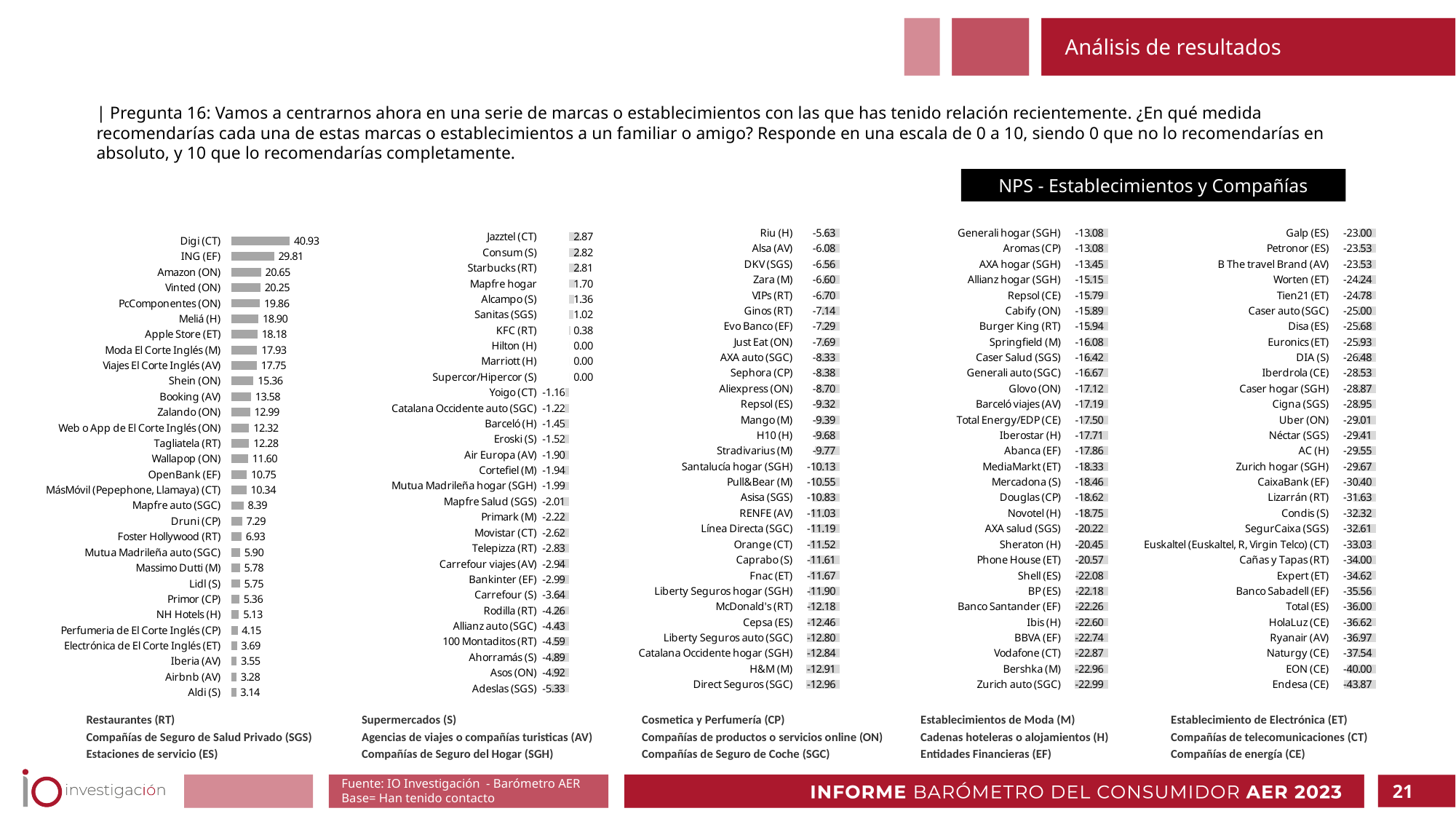
What kind of chart is used to show the NPS values? Bar chart Which brand or establishment has the highest NPS on the chart? Digi (CT) What is the NPS value shown for Digi (CT)? 40.93 How many brands on the chart have an NPS of exactly 0.00? 3 What is the difference between the NPS of Amazon (ON) and Vinted (ON)? 0.40 What is the difference between the NPS of Digi (CT) and ING (EF)? 11.12 Which has a higher NPS, Lidl (S) or Mercadona (S)? Lidl (S) Which brand or establishment has the lowest NPS on the chart? Endesa (CE) What is the NPS value shown for Mercadona (S)? -18.46 What is the NPS value shown for Jazztel (CT)? 2.87 What is the NPS value shown for Ryanair (AV)? -36.97 What is the title shown above the chart? NPS - Establecimientos y Compañías